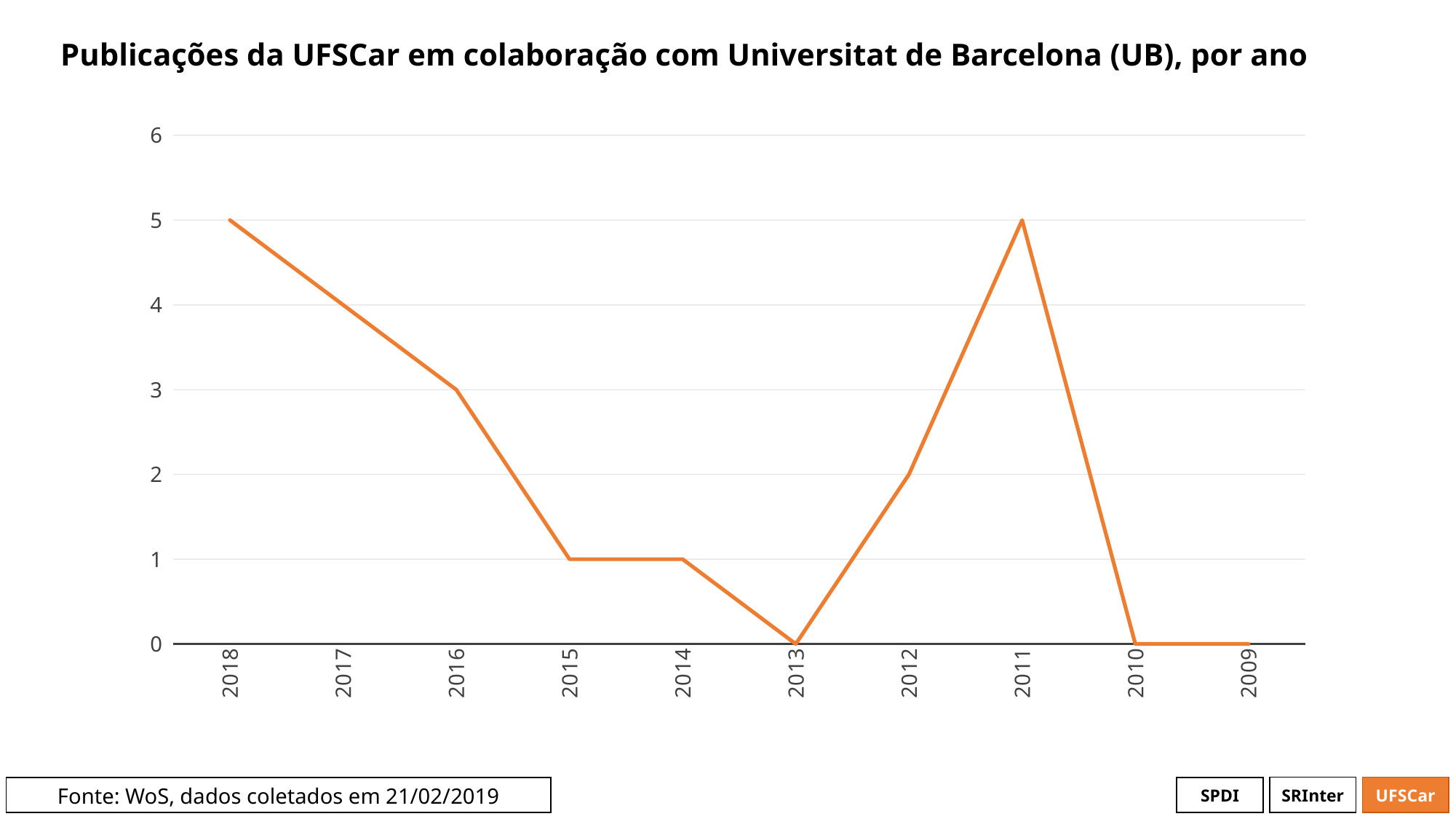
What is the value for 2016? 3 What kind of chart is shown on the slide? line chart What is the value for 2012? 2 What is the data source stated on the slide? WoS, dados coletados em 21/02/2019 What is the difference between the values for 2016 and 2015? 2 What is the value for 2011? 5 Which is larger, the value for 2012 or the value for 2014? 2012 What is the value for 2013? 0 Which years have the highest value? 2018 and 2011 What is the value for 2018? 5 How many years are plotted on the x axis? 10 Is the value for 2017 greater or less than 2? greater